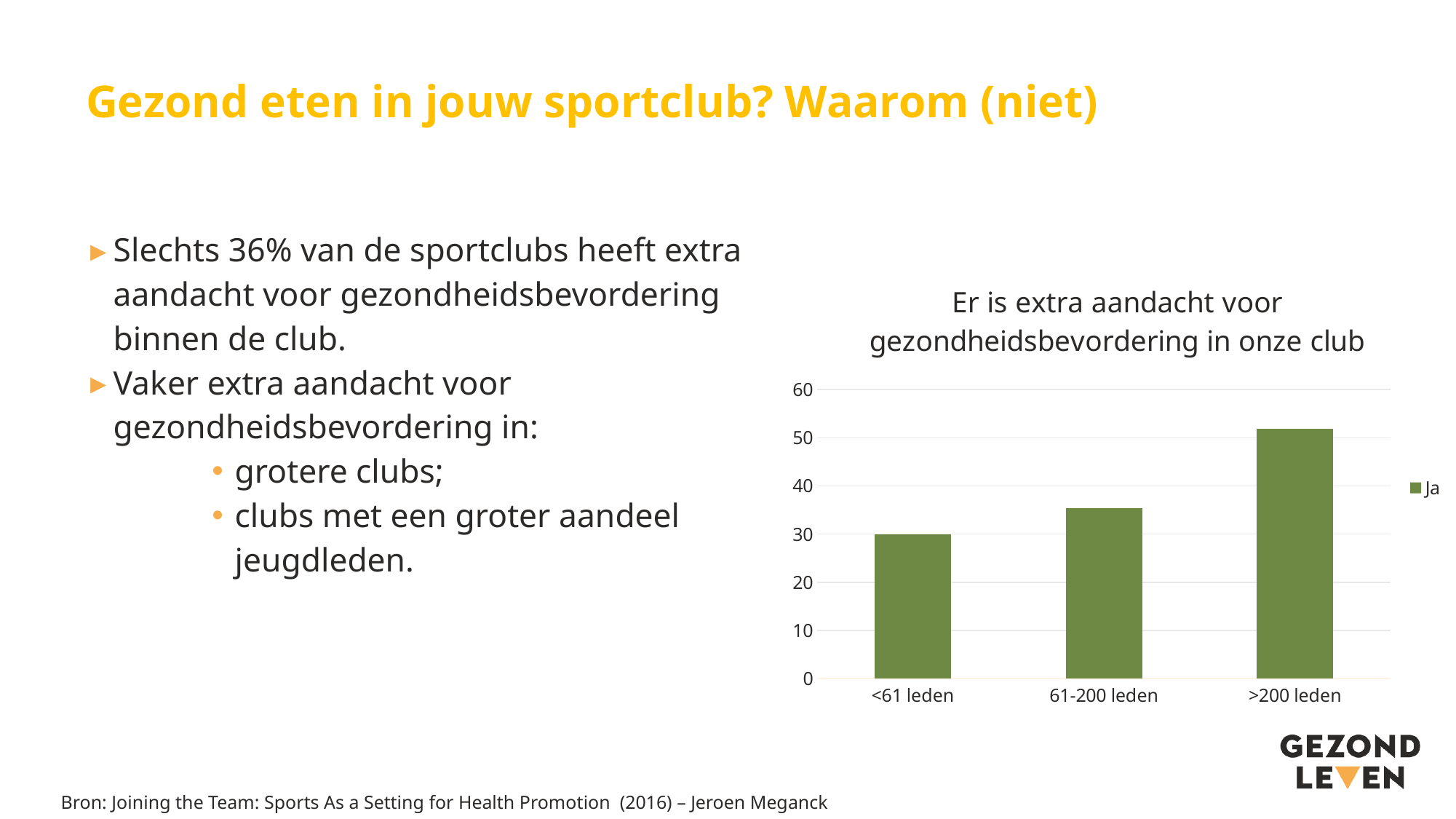
Which is larger: the value for 61-200 leden or the value for <61 leden? 61-200 leden Is the value for 61-200 leden greater or less than 40? less Is the value for >200 leden greater or less than 50? greater How many series does the chart's legend list? 1 Which category has the highest bar in the chart? >200 leden What kind of chart is shown on the slide? bar chart Which category has the lowest bar in the chart? <61 leden Is the value for <61 leden greater or less than 40? less What is the title of the chart? Er is extra aandacht voor gezondheidsbevordering in onze club What is the legend entry shown for the chart's series? Ja How many categories are shown on the x axis of the chart? 3 Do the values rise or fall as club size increases along the x axis? rise